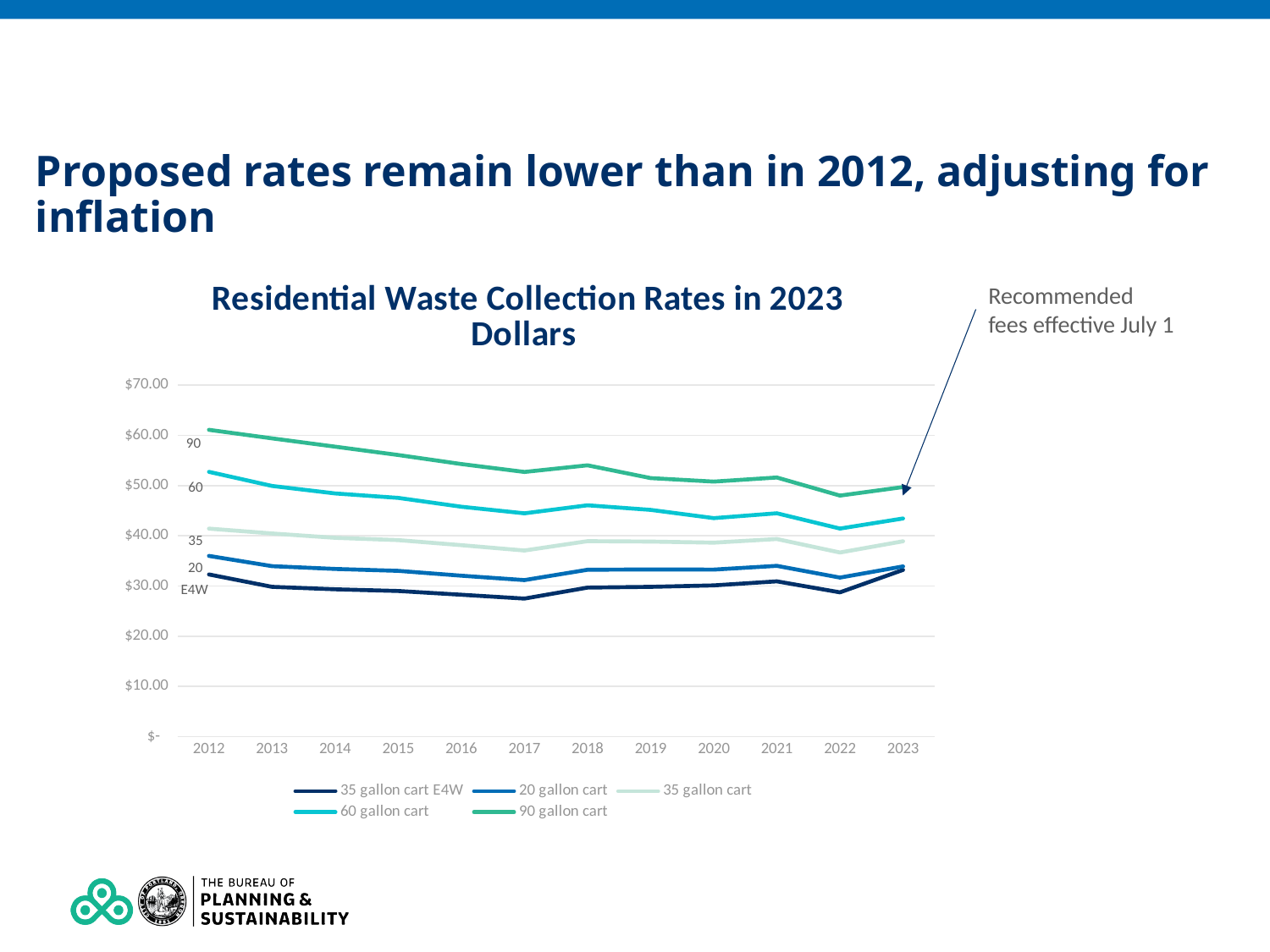
How many series does the legend list? 5 How many years are plotted along the x axis? 12 Is the value for the 90 gallon cart in 2012 greater or less than $50.00? greater Which series has the lowest value in 2017? 35 gallon cart E4W Which series has the highest value in 2023? 90 gallon cart Does the 90 gallon cart line generally rise or fall from 2012 to 2022? fall What kind of chart is shown on the slide? line chart What does the annotation with the arrow pointing to the 2023 value say? Recommended fees effective July 1 What is the title of the chart? Residential Waste Collection Rates in 2023 Dollars Is the value for the 90 gallon cart in 2023 greater or less than $60.00? less Is the value for the 35 gallon cart E4W in 2017 greater or less than $30.00? less